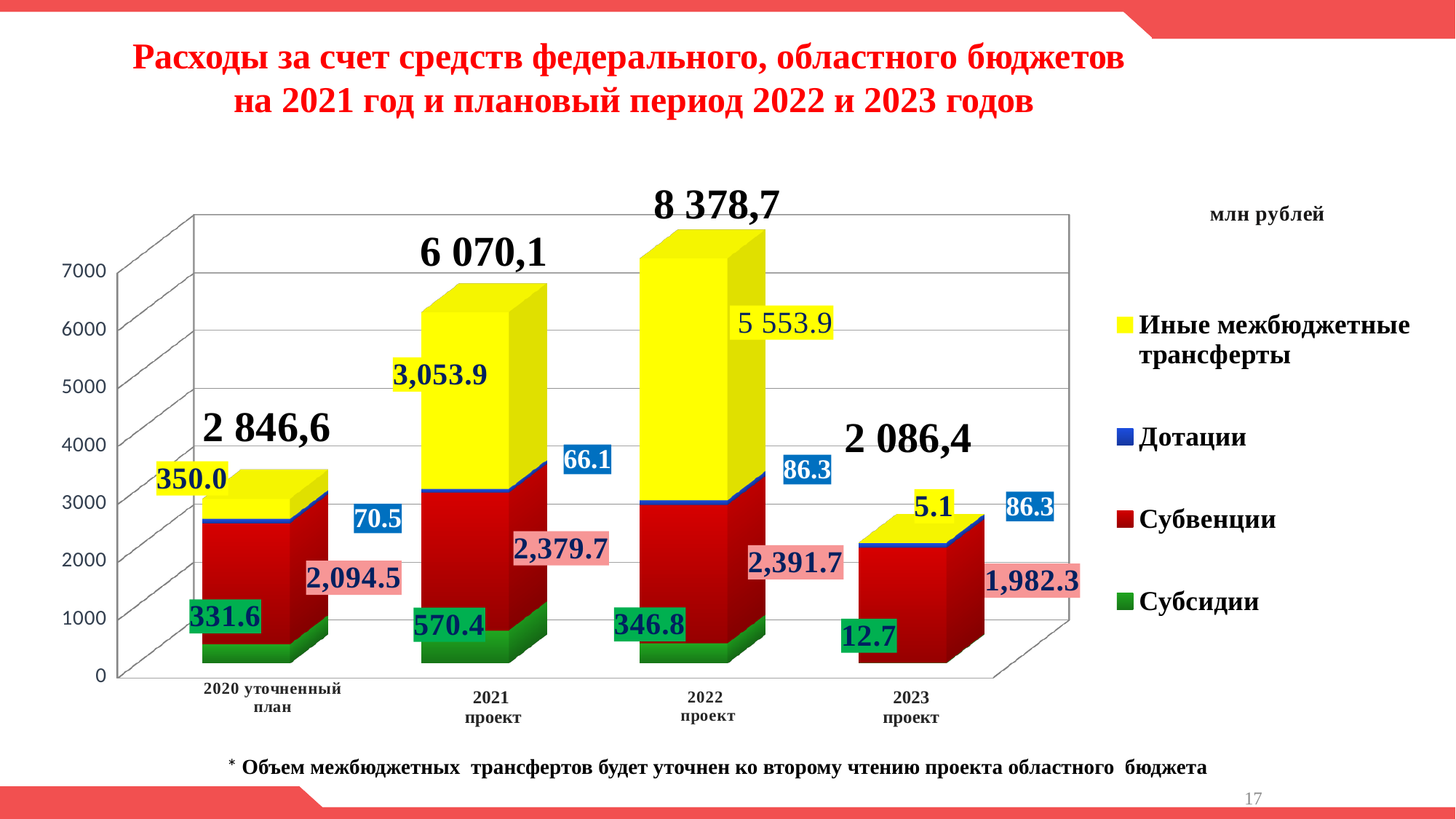
What is the total shown above the bar for 2022 проект? 8 378,7 What is the value of Субвенции for 2023 проект? 1,982.3 Which category has the lowest value for Субсидии? 2023 проект What type of chart is shown on the slide? Stacked bar chart What is the value of Субсидии for 2020 уточненный план? 331.6 What is the value of Дотации for 2022 проект? 86.3 What is the value of Иные межбюджетные трансферты for 2021 проект? 3,053.9 How many series does the legend list? 4 What is the difference between Субсидии for 2021 проект and Субсидии for 2022 проект? 223.6 Which category has the highest total? 2022 проект How many categories are shown on the x axis? 4 Which is larger: Субвенции for 2021 проект or Субвенции for 2022 проект? 2022 проект